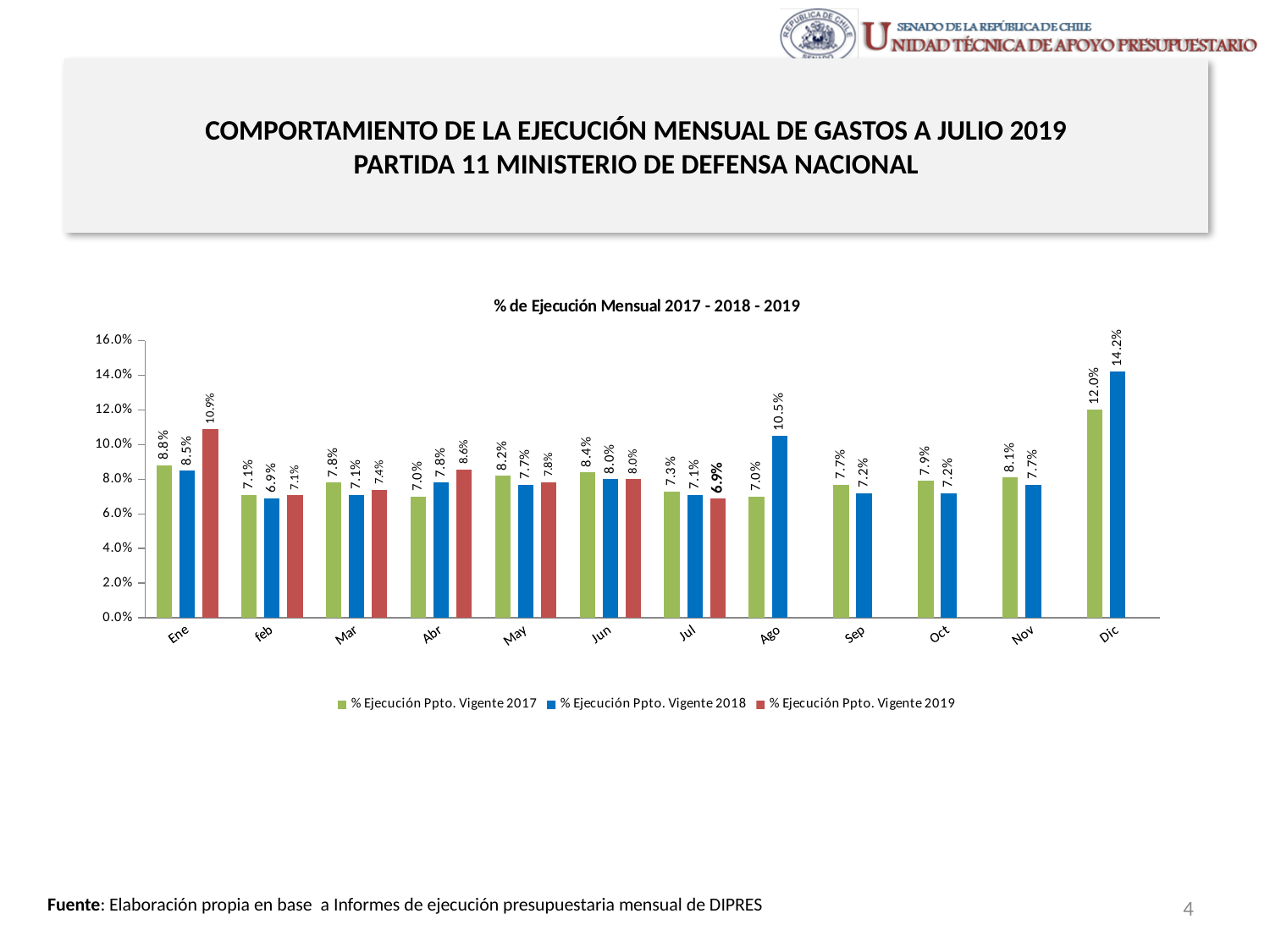
How many months are shown on the x axis? 12 What is the difference between the 2018 and 2017 values in Dic? 2.2% How many series does the legend list? 3 What is the value for % Ejecución Ppto. Vigente 2018 in Ago? 10.5% Which month has the highest value for % Ejecución Ppto. Vigente 2017? Dic In Abr, which is larger: the 2017 value or the 2019 value? 2019 What is the value for % Ejecución Ppto. Vigente 2018 in Dic? 14.2% Is the value for % Ejecución Ppto. Vigente 2018 in Ago greater or less than 10.0%? greater What is the value for % Ejecución Ppto. Vigente 2017 in Jun? 8.4% Which month has the lowest value for % Ejecución Ppto. Vigente 2019? Jul What is the value for % Ejecución Ppto. Vigente 2019 in Ene? 10.9% What kind of chart is shown on the slide? Bar chart